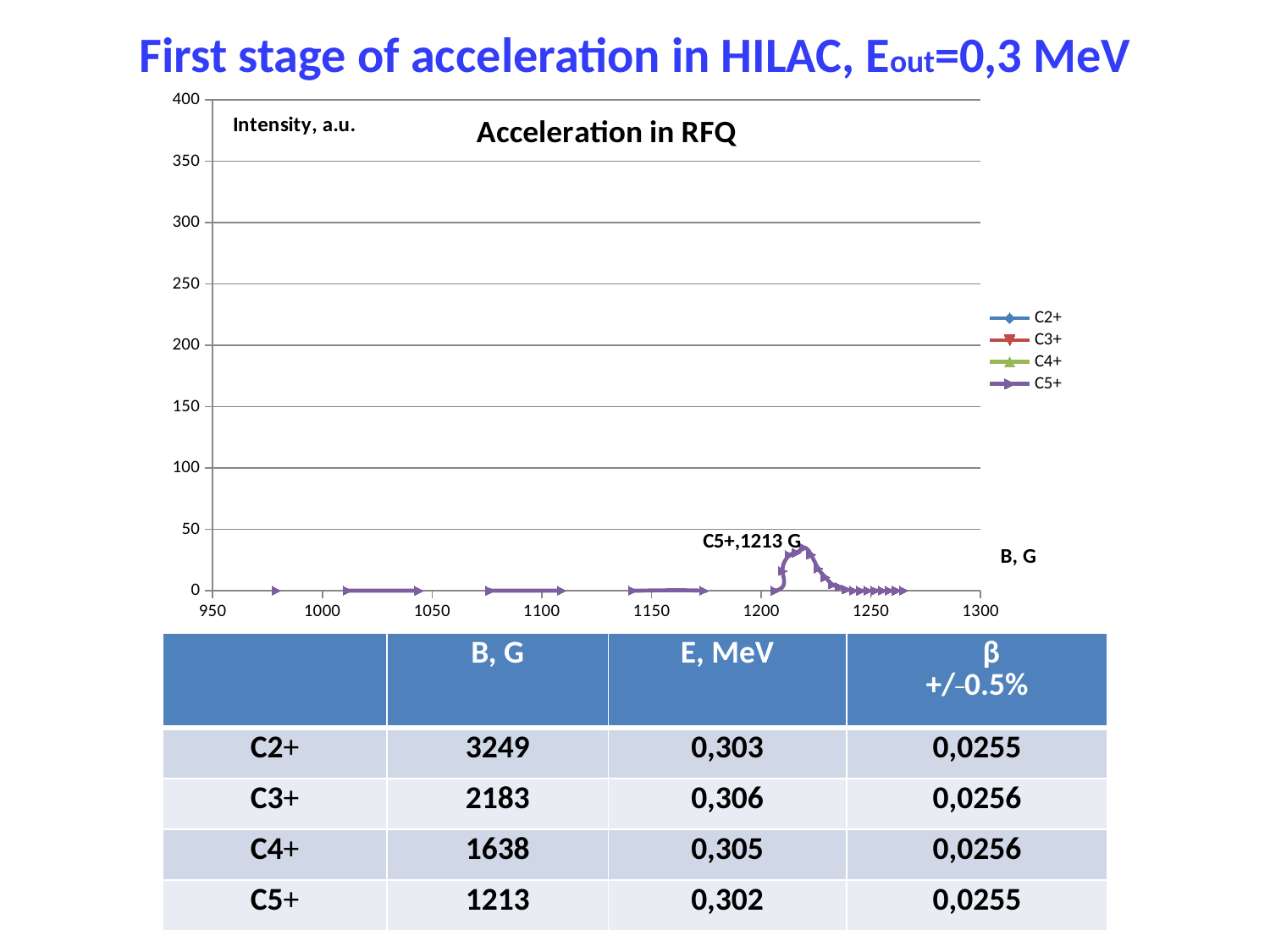
What is the label on the horizontal axis of the chart? B, G Is the peak intensity of the C5+ series greater or less than 100? less What kind of chart is shown on the slide? line chart Is the peak intensity of the C5+ series greater or less than 50? less What is the maximum value shown on the vertical axis of the chart? 400 Which series has its peak annotated on the chart? C5+ How many series does the legend of the chart list? 4 What is the title of the chart? Acceleration in RFQ Which series are listed in the chart legend? C2+, C3+, C4+, C5+ What is the minimum value shown on the horizontal axis of the chart? 950 What is the label on the vertical axis of the chart? Intensity, a.u. What text annotation is placed next to the peak of the plotted curve? C5+,1213 G